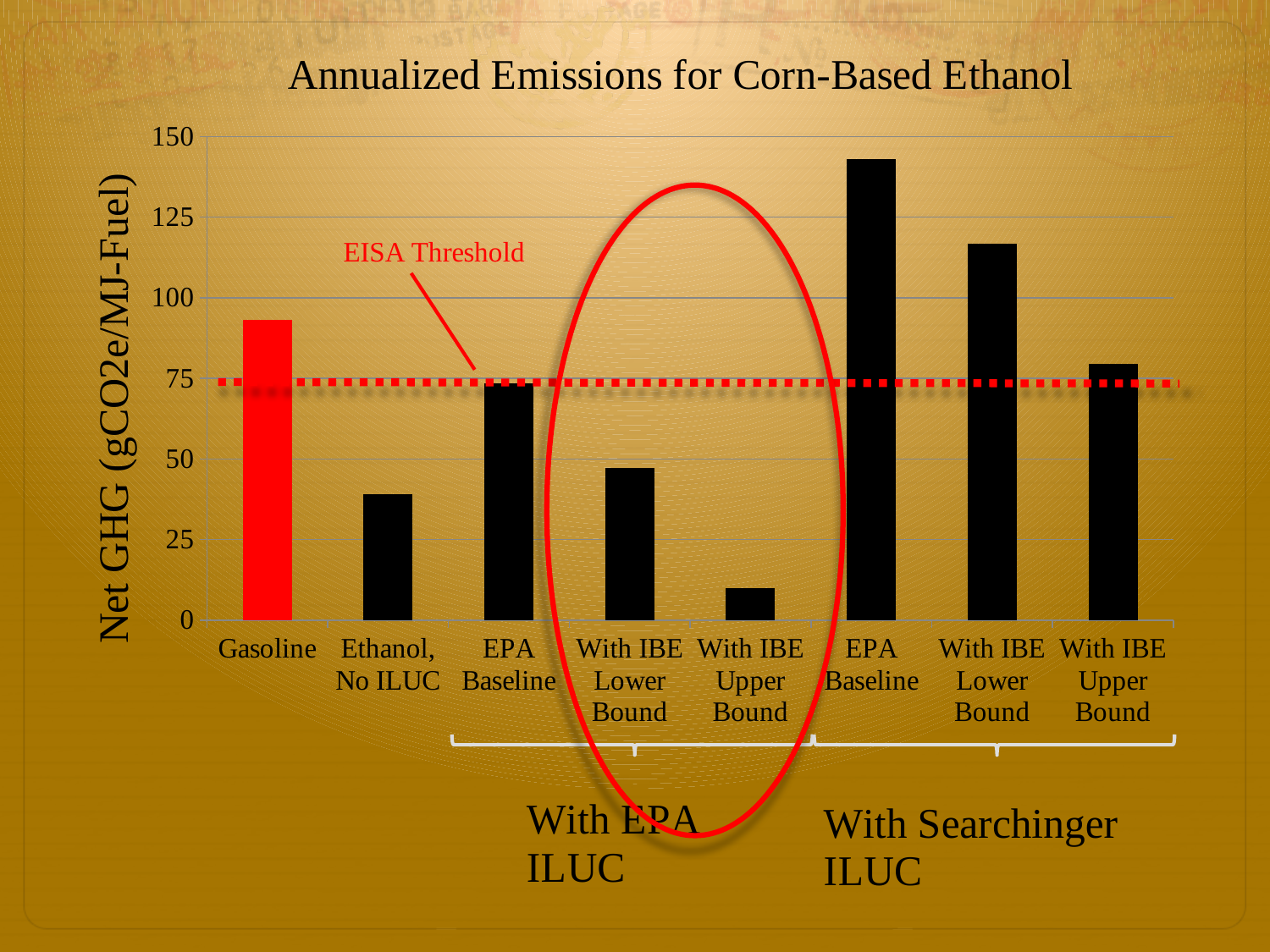
How many bars are plotted in the chart? 8 Is the value for Gasoline greater or less than 75? greater Is the value for Ethanol, No ILUC greater or less than 50? less Which is larger, the value for Gasoline or the value for Ethanol, No ILUC? Gasoline What is the title of the chart? Annualized Emissions for Corn-Based Ethanol Which bar has the highest value in the chart? EPA Baseline (With Searchinger ILUC) Is the value for EPA Baseline under With Searchinger ILUC greater or less than 125? greater Which is larger, the With IBE Lower Bound value under With EPA ILUC or the With IBE Lower Bound value under With Searchinger ILUC? With IBE Lower Bound under With Searchinger ILUC Which bar has the lowest value in the chart? With IBE Upper Bound (With EPA ILUC) What is the label on the y axis of the chart? Net GHG (gCO2e/MJ-Fuel) What kind of chart is shown on the slide? bar chart